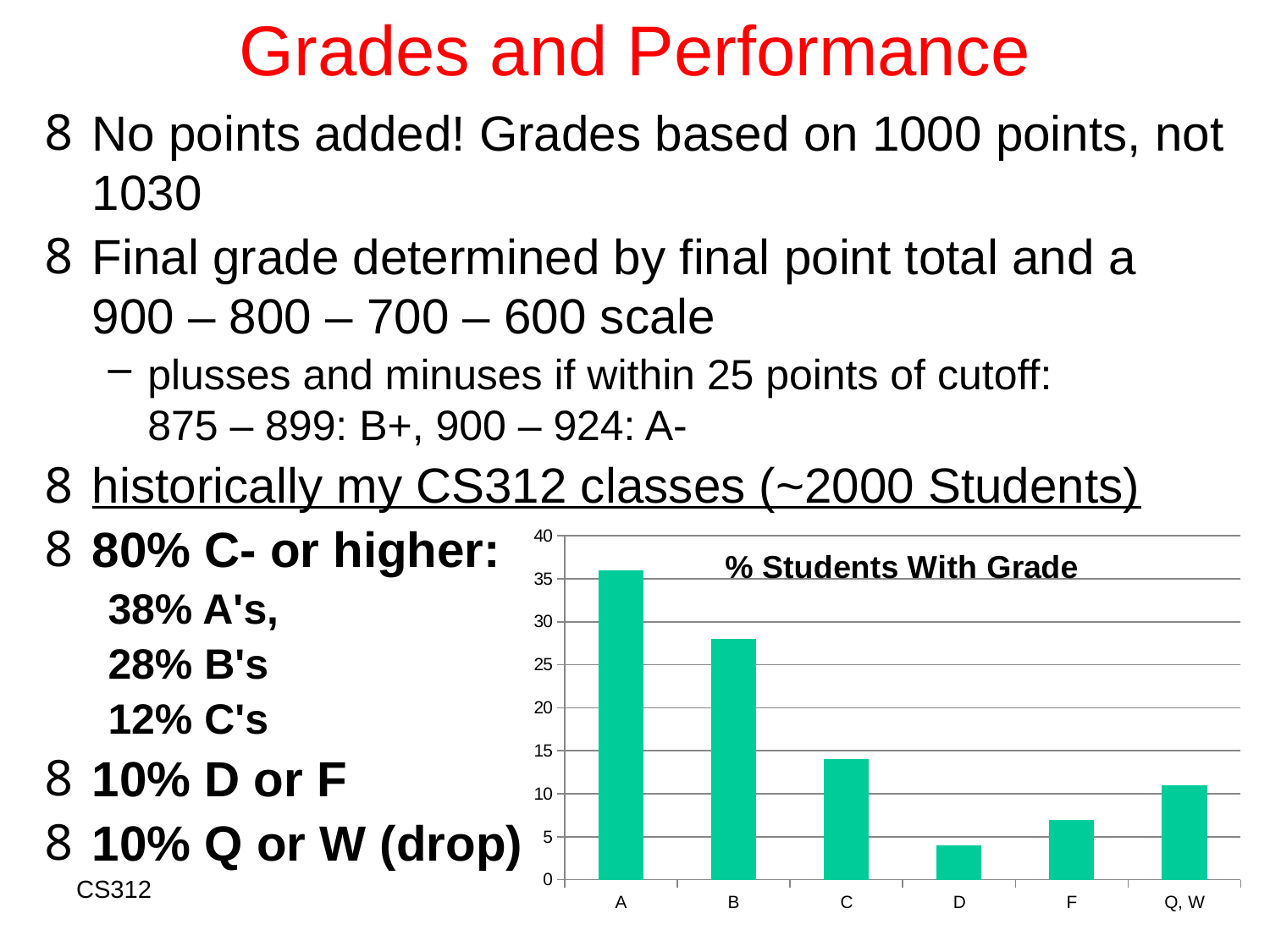
Is the value for D greater or less than 5? less How many grade categories are plotted on the x axis of the chart? 6 Is the value for A greater or less than 35? greater What is the title of the chart? % Students With Grade Which is larger, the value for F or the value for Q, W? Q, W Is the value for C greater or less than 15? less Which grade category has the shortest bar in the chart? D What kind of chart is shown on the slide? bar chart Which grade category has the tallest bar in the chart? A Do the bar values rise or fall from A to D along the x axis? fall